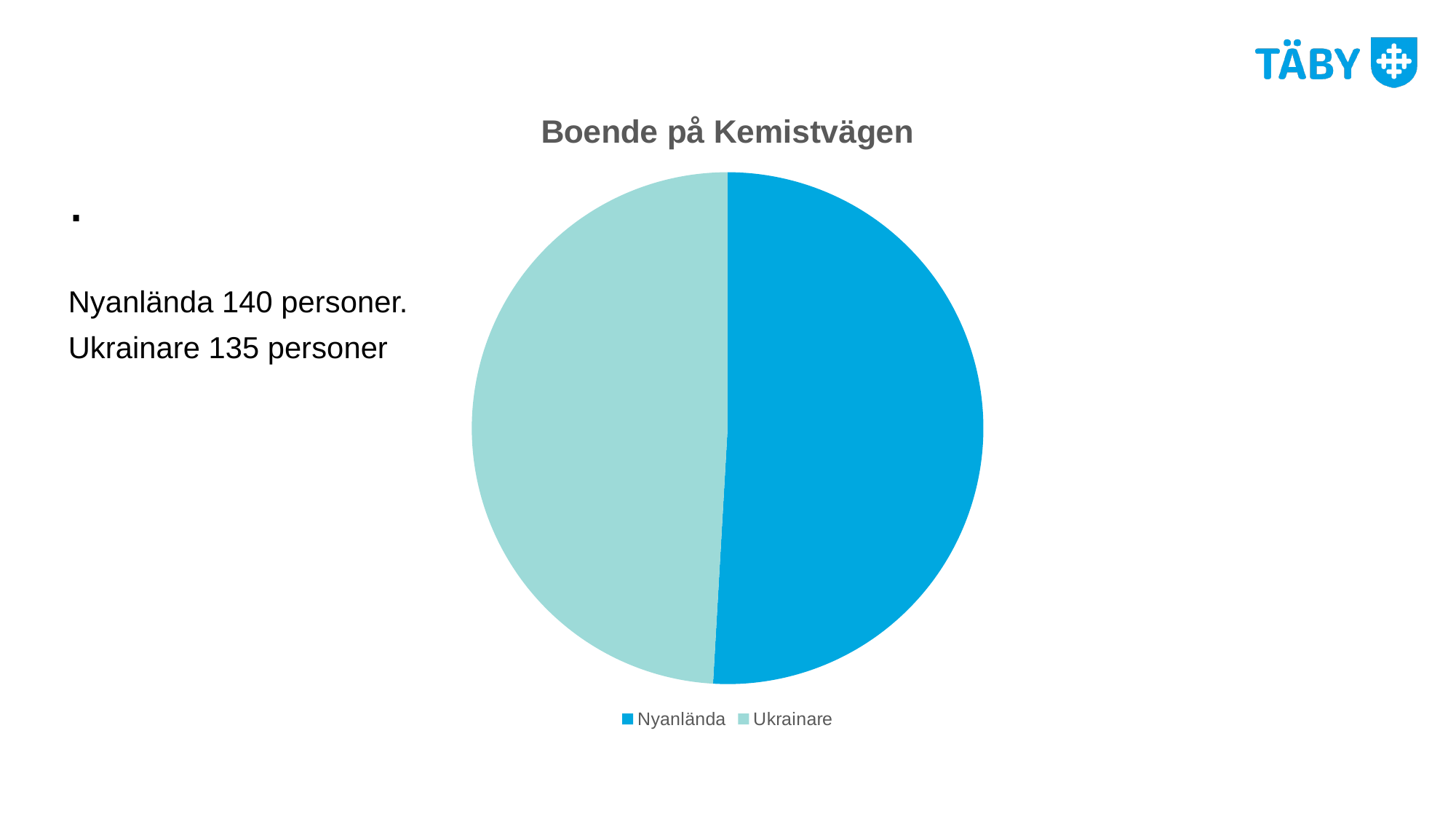
How many slices does the pie chart have? 2 How many persons are Nyanlända according to the slide? 140 personer How many entries does the legend list? 2 What is the difference in persons between Nyanlända and Ukrainare? 5 What kind of chart is shown on the slide? pie chart Which group is larger, Nyanlända or Ukrainare? Nyanlända What is the total number of persons across both groups? 275 How many persons are Ukrainare according to the slide? 135 personer Which colour represents Ukrainare in the pie chart? light teal What is the title of the chart? Boende på Kemistvägen